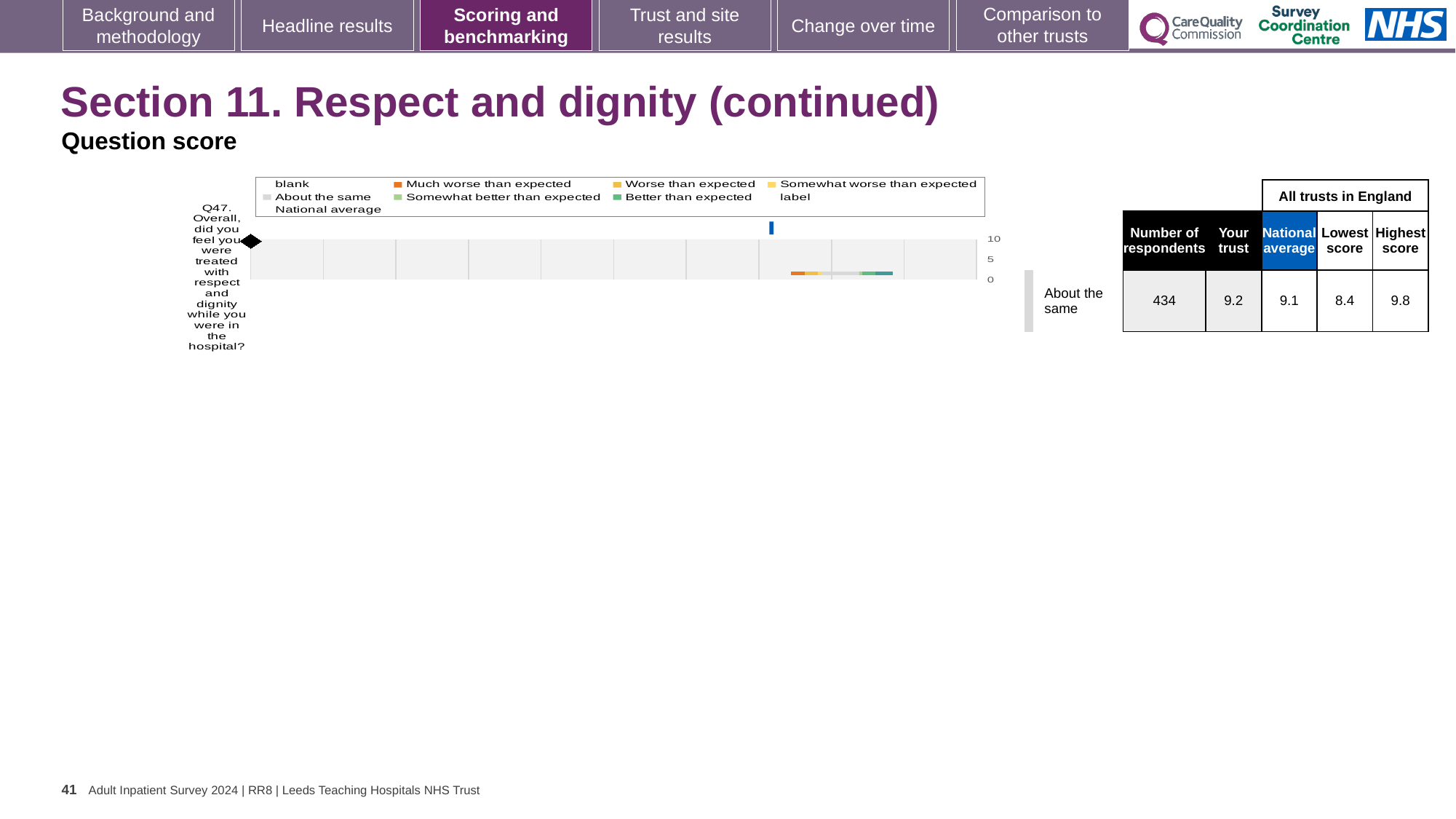
What is the lowest score among all trusts in England for Q47? 8.4 What is the national average score for Q47? 9.1 What is the highest score among all trusts in England for Q47? 9.8 How many respondents answered Q47? 434 What kind of chart is shown on the slide? bar chart What is the trust's score for Q47? 9.2 What is the difference between the highest and lowest scores among all trusts in England for Q47? 1.4 Which benchmark category is Q47 placed in? About the same Which is larger for Q47, the trust's score or the national average? the trust's score Which question is plotted on the chart? Q47. Overall, did you feel you were treated with respect and dignity while you were in the hospital? What is the highest value shown on the chart's score axis? 10 How many questions (categories) are plotted on the chart? 1